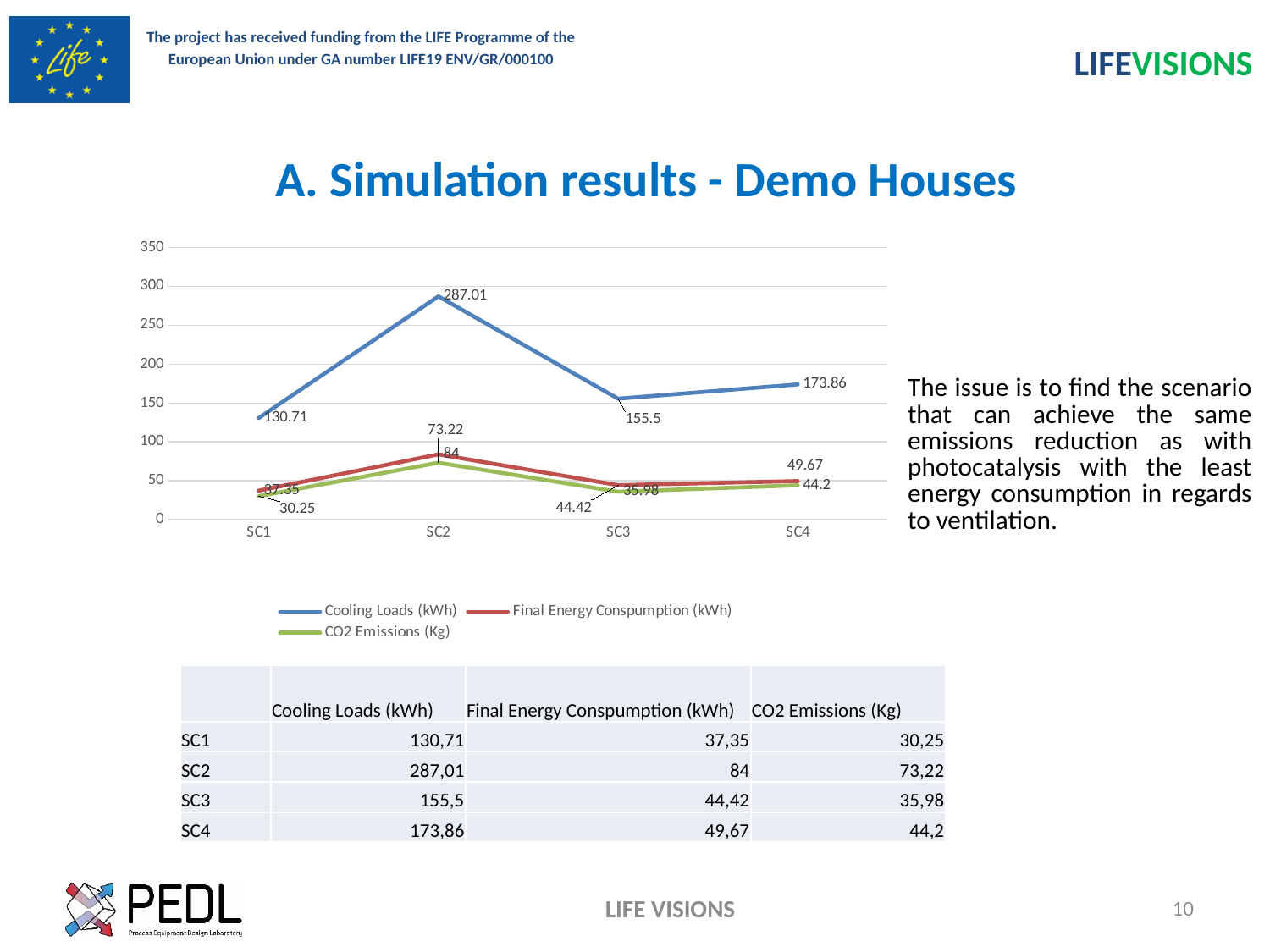
What is the Cooling Loads (kWh) value for SC2? 287.01 What is the Final Energy Consumption (kWh) value for SC4? 49.67 How many series does the chart legend list? 3 What kind of chart is shown on the slide? Line chart How many scenarios are shown on the x axis of the chart? 4 Which series is drawn in green in the chart? CO2 Emissions (Kg) Which is larger, the Cooling Loads (kWh) for SC4 or for SC3? SC4 Is the Cooling Loads (kWh) value for SC3 greater or less than 150? greater Which scenario has the highest Cooling Loads (kWh)? SC2 What is the difference in Cooling Loads (kWh) between SC2 and SC1? 156.30 What is the CO2 Emissions (Kg) value for SC1? 30.25 Which scenario has the lowest CO2 Emissions (Kg)? SC1